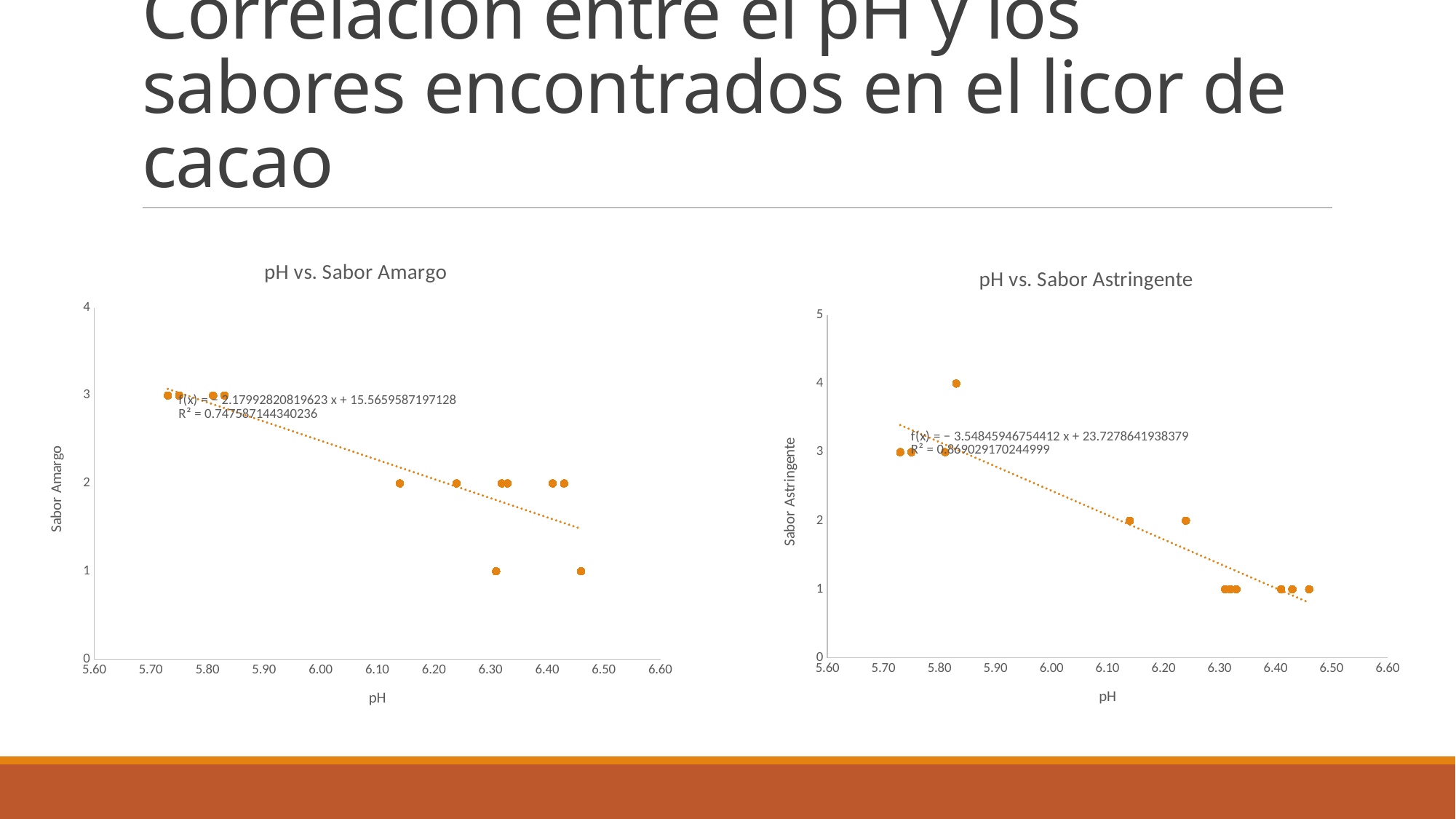
Which chart has the higher R² value, "pH vs. Sabor Amargo" or "pH vs. Sabor Astringente"? pH vs. Sabor Astringente What type of chart is "pH vs. Sabor Amargo"? Scatter chart What is the label of the x axis in the "pH vs. Sabor Astringente" chart? pH What type of chart is "pH vs. Sabor Astringente"? Scatter chart In the "pH vs. Sabor Amargo" chart, what is the trendline equation shown? f(x) = − 2.17992820819623 x + 15.5659587197128 In the "pH vs. Sabor Amargo" chart, do the Sabor Amargo values rise or fall as pH increases? Fall In the "pH vs. Sabor Astringente" chart, what is the highest Sabor Astringente value plotted? 4 In the "pH vs. Sabor Astringente" chart, do the Sabor Astringente values rise or fall as pH increases? Fall In the "pH vs. Sabor Astringente" chart, what is the R² value shown for the trendline? 0.869029170244999 In the "pH vs. Sabor Amargo" chart, what is the R² value shown for the trendline? 0.747587144340236 In the "pH vs. Sabor Amargo" chart, what is the lowest Sabor Amargo value plotted? 1 What is the label of the y axis in the "pH vs. Sabor Amargo" chart? Sabor Amargo